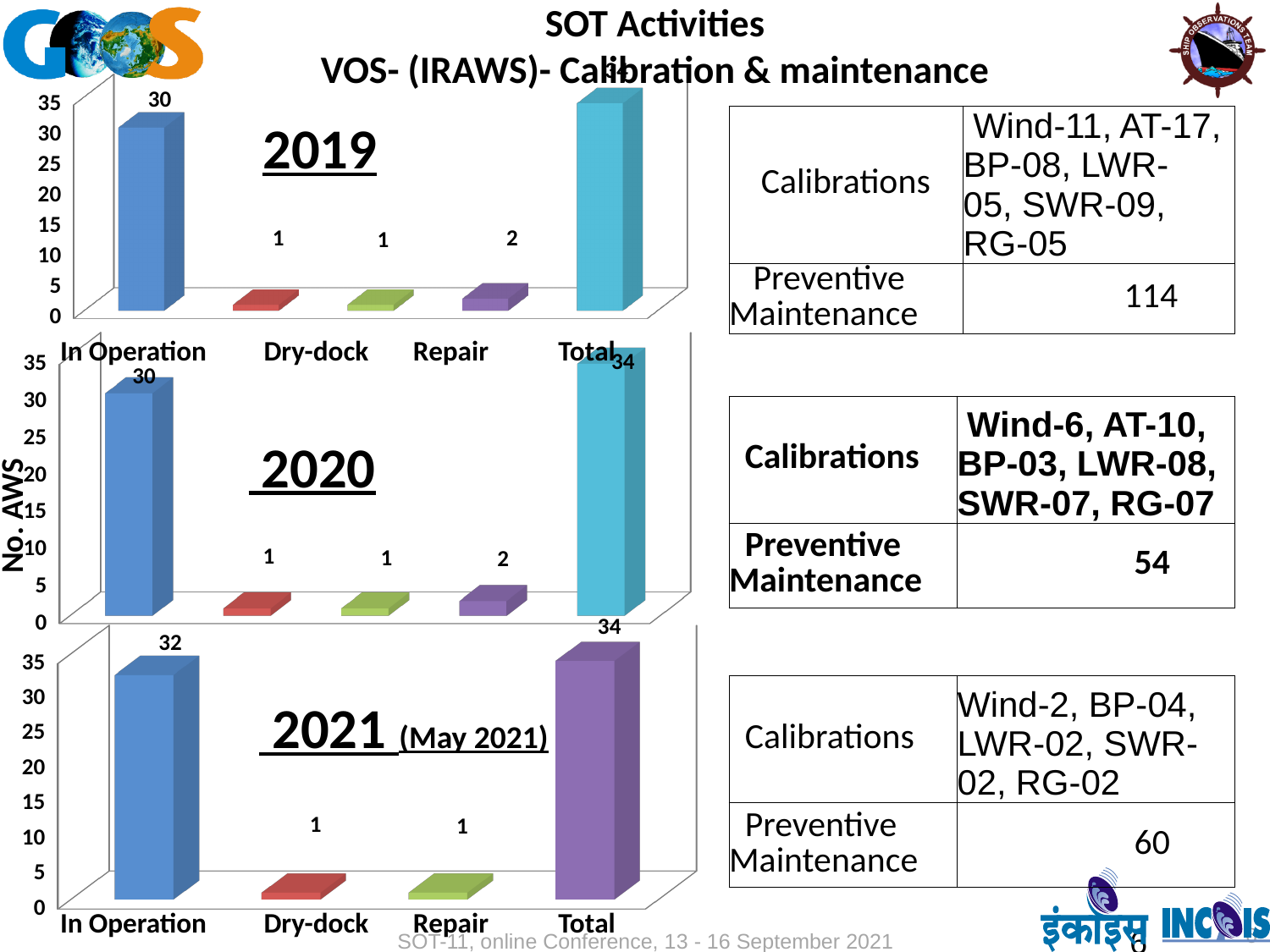
In the 2020 chart, what is the value for Total? 34 In the 2021 (May 2021) chart, what is the difference between Total and In Operation? 2 In the 2021 (May 2021) chart, what is the value for In Operation? 32 In the 2019 chart, which category has the highest value? Total What kind of chart is the 2021 (May 2021) chart? Bar chart In the 2020 chart, which is larger, In Operation or Total? Total In the 2020 chart, what is the difference between the Total value and the In Operation value? 4 In the 2019 chart, what is the value for In Operation? 30 What is the label on the vertical axis of the charts? No. AWS In the 2020 chart, what is the value for Repair? 1 In the 2019 chart, what is the value for Dry-dock? 1 In the 2021 (May 2021) chart, how many categories are shown on the x axis? 4